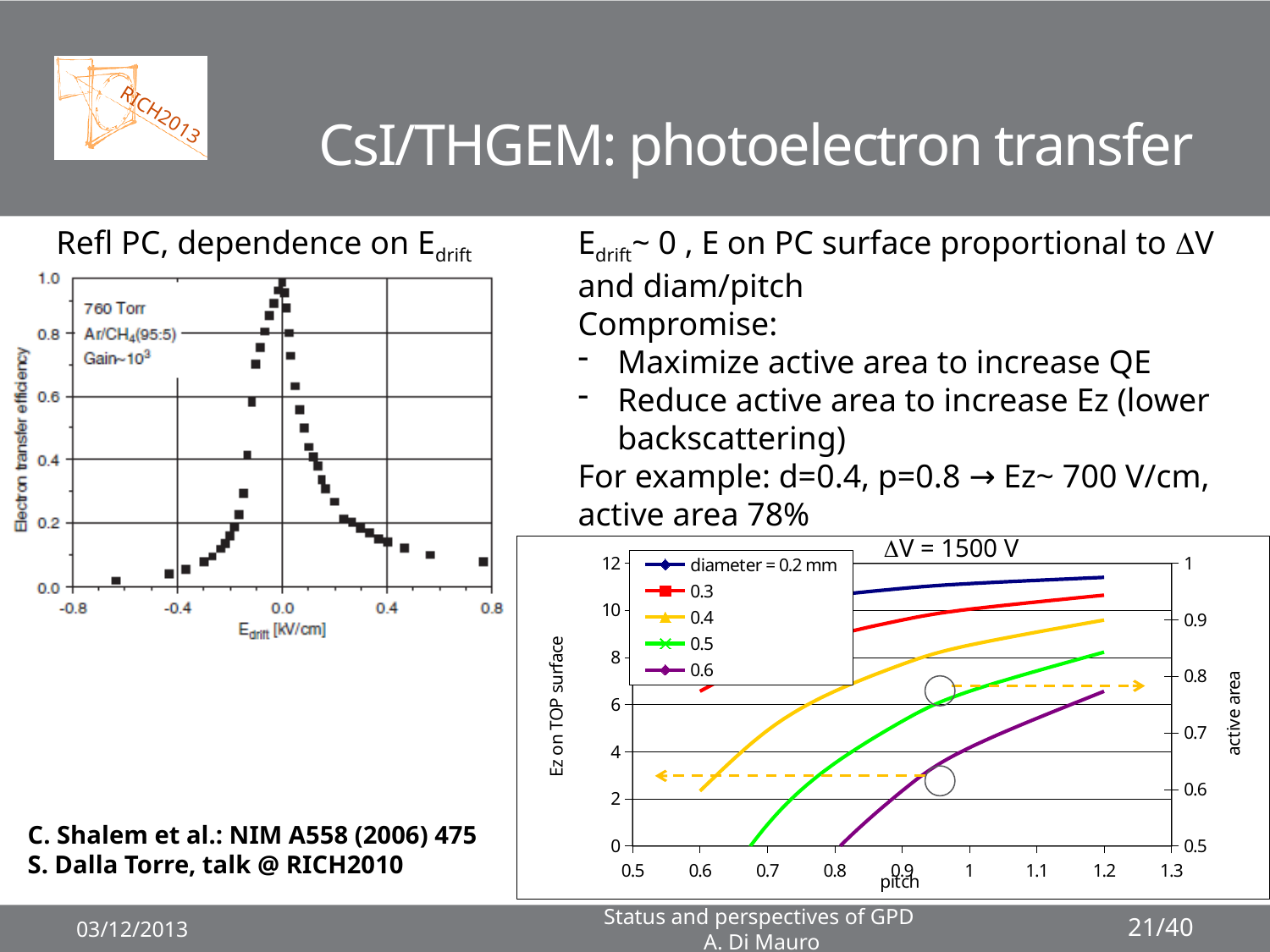
In the right-hand chart, is the Ez value for the 0.6 series at pitch 0.9 greater or less than 4? less What is the title shown above the right-hand chart? ΔV = 1500 V In the right-hand chart, do the Ez values rise or fall as pitch increases? rise What kind of chart is the chart on the right of the slide (Ez on TOP surface vs pitch)? line chart What is the x-axis label of the left-hand chart (Refl PC, dependence on E_drift)? E_drift [kV/cm] In the right-hand chart, which series has the lowest Ez on TOP surface across the pitch range? 0.6 In the right-hand chart, which series has the highest Ez on TOP surface across the pitch range? diameter = 0.2 mm In the right-hand chart, is the Ez value for the 0.2 mm series at pitch 1.2 greater or less than 10? greater How many series does the legend of the right-hand chart list? 5 In the left-hand chart, do the electron transfer efficiency values rise or fall as E_drift increases from 0.0 to 0.8 kV/cm? fall In the right-hand chart, which is larger at pitch 1.0: the Ez value for the 0.3 series or for the 0.5 series? 0.3 In the left-hand chart, is the electron transfer efficiency at E_drift = 0.4 kV/cm greater or less than 0.2? less